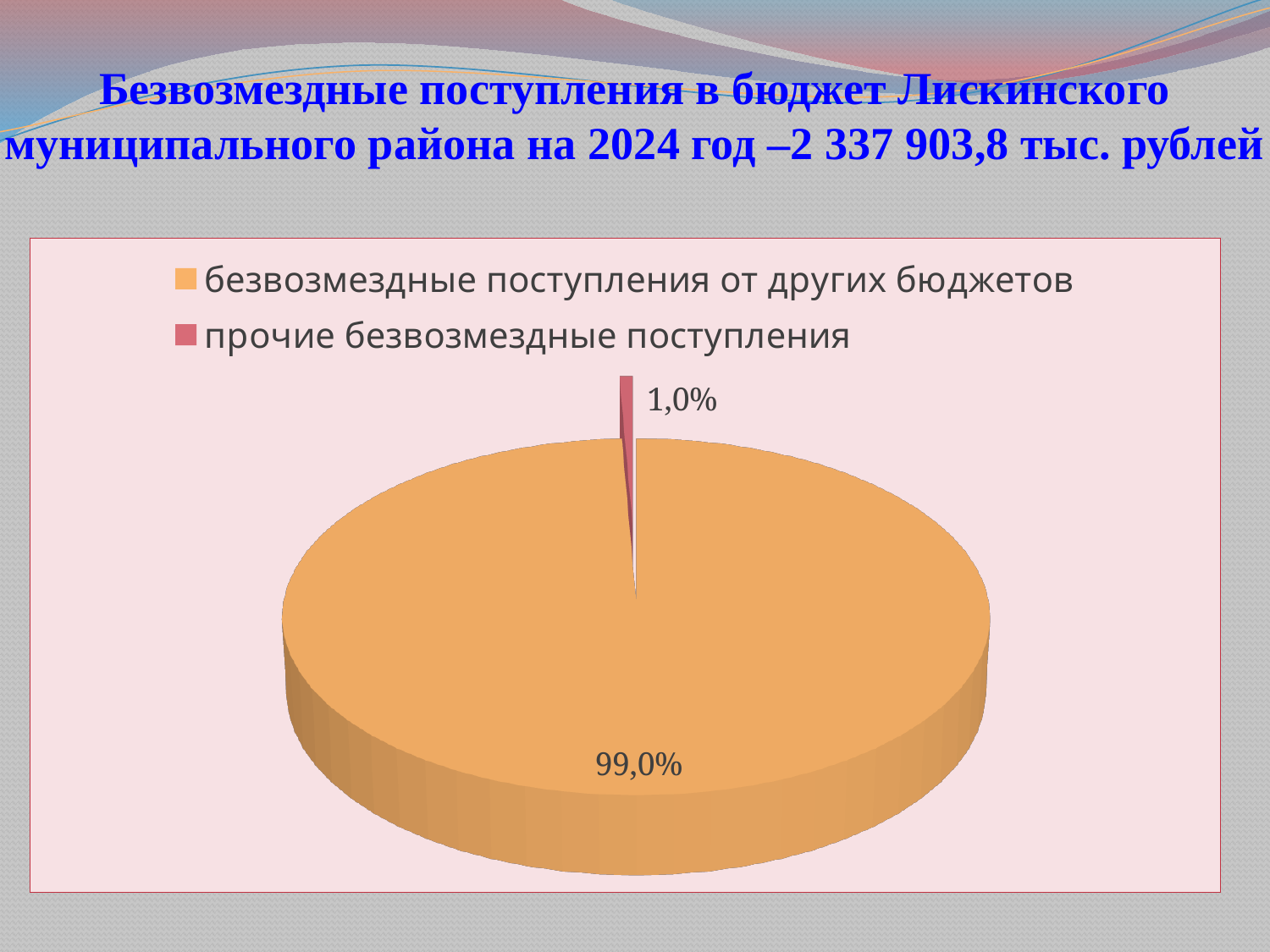
Which category has the smallest share of the pie? прочие безвозмездные поступления Which is larger: the share of 'прочие безвозмездные поступления' or the share of 'безвозмездные поступления от других бюджетов'? безвозмездные поступления от других бюджетов What total amount of gratuitous receipts for 2024 is stated in the slide title? 2 337 903,8 тыс. рублей How many slices does the pie chart have? 2 What is the difference in percentage points between the shares of 'безвозмездные поступления от других бюджетов' and 'прочие безвозмездные поступления'? 98,0% How many entries does the legend list? 2 What share of the pie does 'прочие безвозмездные поступления' take? 1,0% Which category has the largest share of the pie? безвозмездные поступления от других бюджетов What share of the pie does 'безвозмездные поступления от других бюджетов' take? 99,0% What kind of chart is shown on the slide? pie chart What colour is the slice for 'прочие безвозмездные поступления'? red